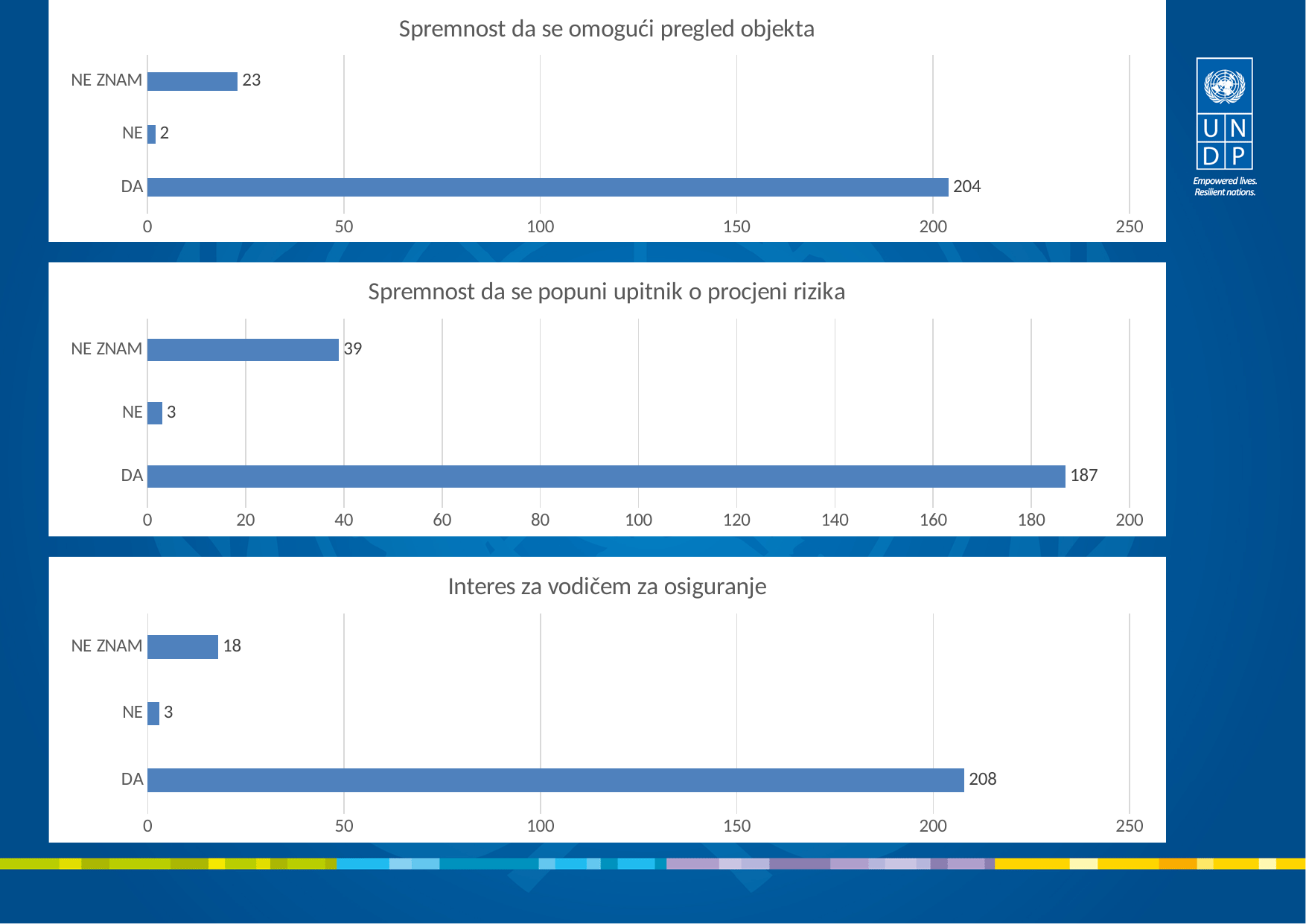
In the chart titled "Interes za vodičem za osiguranje", what is the value for NE? 3 In the chart titled "Interes za vodičem za osiguranje", what is the difference between the values for NE ZNAM and NE? 15 In the chart titled "Spremnost da se omogući pregled objekta", what is the value for DA? 204 In the chart titled "Spremnost da se popuni upitnik o procjeni rizika", which category has the lowest value? NE In the chart titled "Interes za vodičem za osiguranje", which category has the highest value? DA In the chart titled "Spremnost da se popuni upitnik o procjeni rizika", is the value for DA greater or less than 180? greater In the chart titled "Spremnost da se omogući pregled objekta", what is the difference between the values for DA and NE ZNAM? 181 What type of chart is the top chart on the slide? Bar chart How many categories are shown in the chart titled "Interes za vodičem za osiguranje"? 3 Which is larger: the DA value in the top chart or the DA value in the bottom chart? The bottom chart (208) In the chart titled "Spremnost da se popuni upitnik o procjeni rizika", what is the value for NE ZNAM? 39 In the chart titled "Spremnost da se omogući pregled objekta", what is the value for NE ZNAM? 23